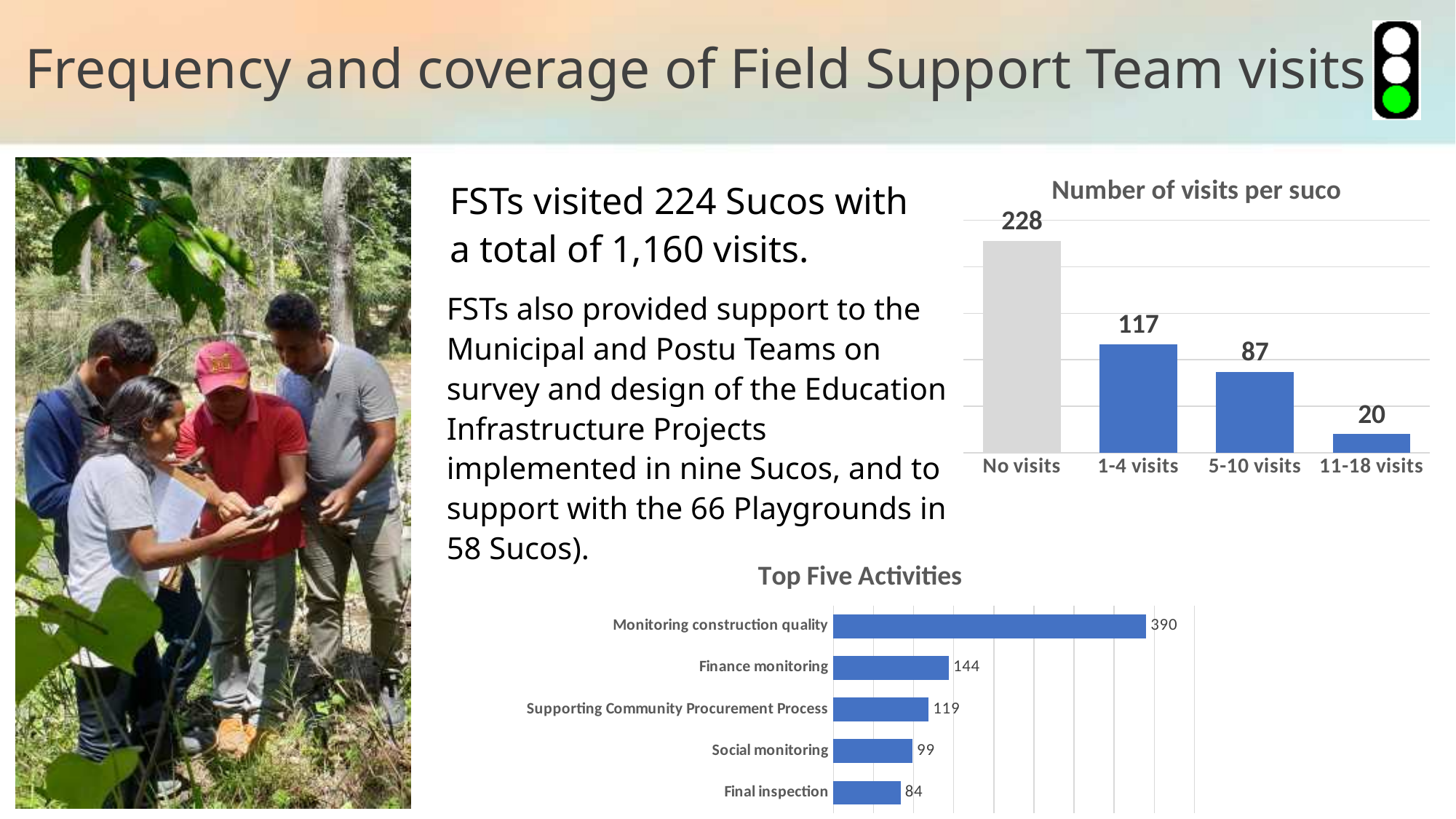
What kind of chart is the 'Top Five Activities' chart? bar chart In the 'Top Five Activities' chart, what is the value for 'Finance monitoring'? 144 In the 'Number of visits per suco' chart, which category has the lowest value? 11-18 visits In the 'Number of visits per suco' chart, what is the difference between '1-4 visits' and '5-10 visits'? 30 In the 'Top Five Activities' chart, which activity has the highest value? Monitoring construction quality In the 'Top Five Activities' chart, what is the difference between 'Monitoring construction quality' and 'Finance monitoring'? 246 In the 'Top Five Activities' chart, what is the value for 'Final inspection'? 84 In the 'Number of visits per suco' chart, what is the value for 'No visits'? 228 In the 'Number of visits per suco' chart, what is the value for '5-10 visits'? 87 In the 'Number of visits per suco' chart, do the values rise or fall from left to right? fall In the 'Top Five Activities' chart, which is larger: 'Supporting Community Procurement Process' or 'Social monitoring'? Supporting Community Procurement Process In the 'Number of visits per suco' chart, how many categories are shown? 4